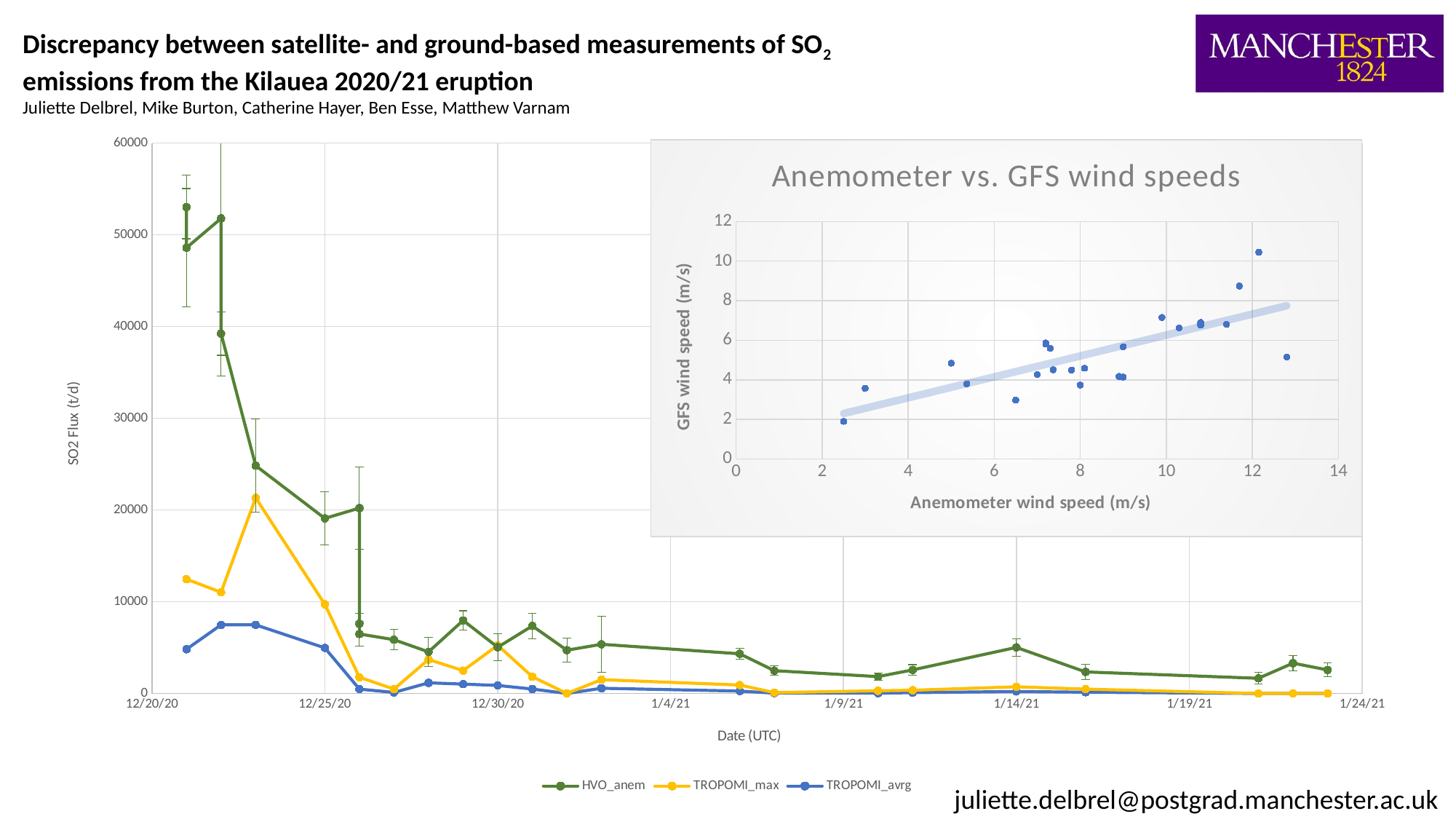
In the SO2 Flux chart, is the highest TROPOMI_avrg value greater or less than 10000? less How many series does the legend of the SO2 Flux chart list? 3 In the SO2 Flux chart, which series has the highest value at the first date plotted? HVO_anem In the inset 'Anemometer vs. GFS wind speeds' chart, does GFS wind speed generally rise or fall as anemometer wind speed increases? rise In the SO2 Flux chart, is the highest TROPOMI_max value greater or less than 15000? greater In the SO2 Flux chart, does the HVO_anem series generally rise or fall from 12/20/20 to 1/24/21? fall What kind of chart is the large chart on the left showing SO2 Flux against Date? line chart What are the three series named in the legend of the SO2 Flux chart? HVO_anem, TROPOMI_max, TROPOMI_avrg What kind of chart is the inset 'Anemometer vs. GFS wind speeds' chart? scatter chart In the SO2 Flux chart, is the first HVO_anem value just after 12/20/20 greater or less than 40000? greater What is the title of the inset chart in the upper right? Anemometer vs. GFS wind speeds